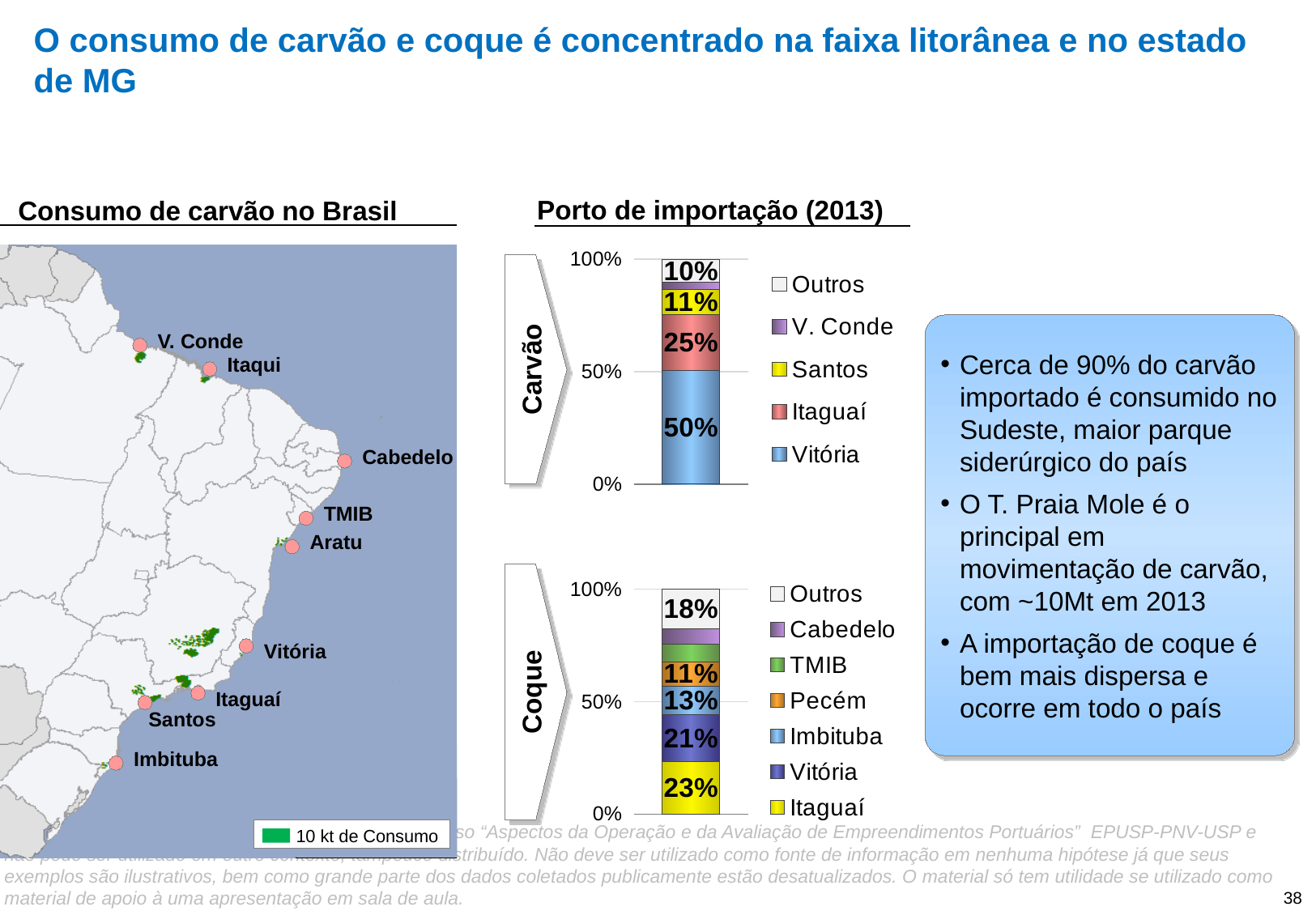
In the Carvão chart, what percentage is shown for Itaguaí? 25% In the Coque chart, which is larger, the share of Imbituba or the share of Pecém? Imbituba How many entries does the legend of the Carvão chart list? 5 What kind of chart is used for the Carvão and Coque port data? Stacked bar chart In the Carvão chart, what percentage is shown for Santos? 11% In the Carvão chart, which port has the largest share? Vitória How many entries does the legend of the Coque chart list? 7 In the Carvão chart, what percentage is shown for Vitória? 50% In the Coque chart, what percentage is shown for Outros? 18% In the Carvão chart, what is the difference between the shares of Vitória and Itaguaí? 25 percentage points In the Coque chart, what percentage is shown for Itaguaí? 23% In the Coque chart, what percentage is shown for Imbituba? 13%